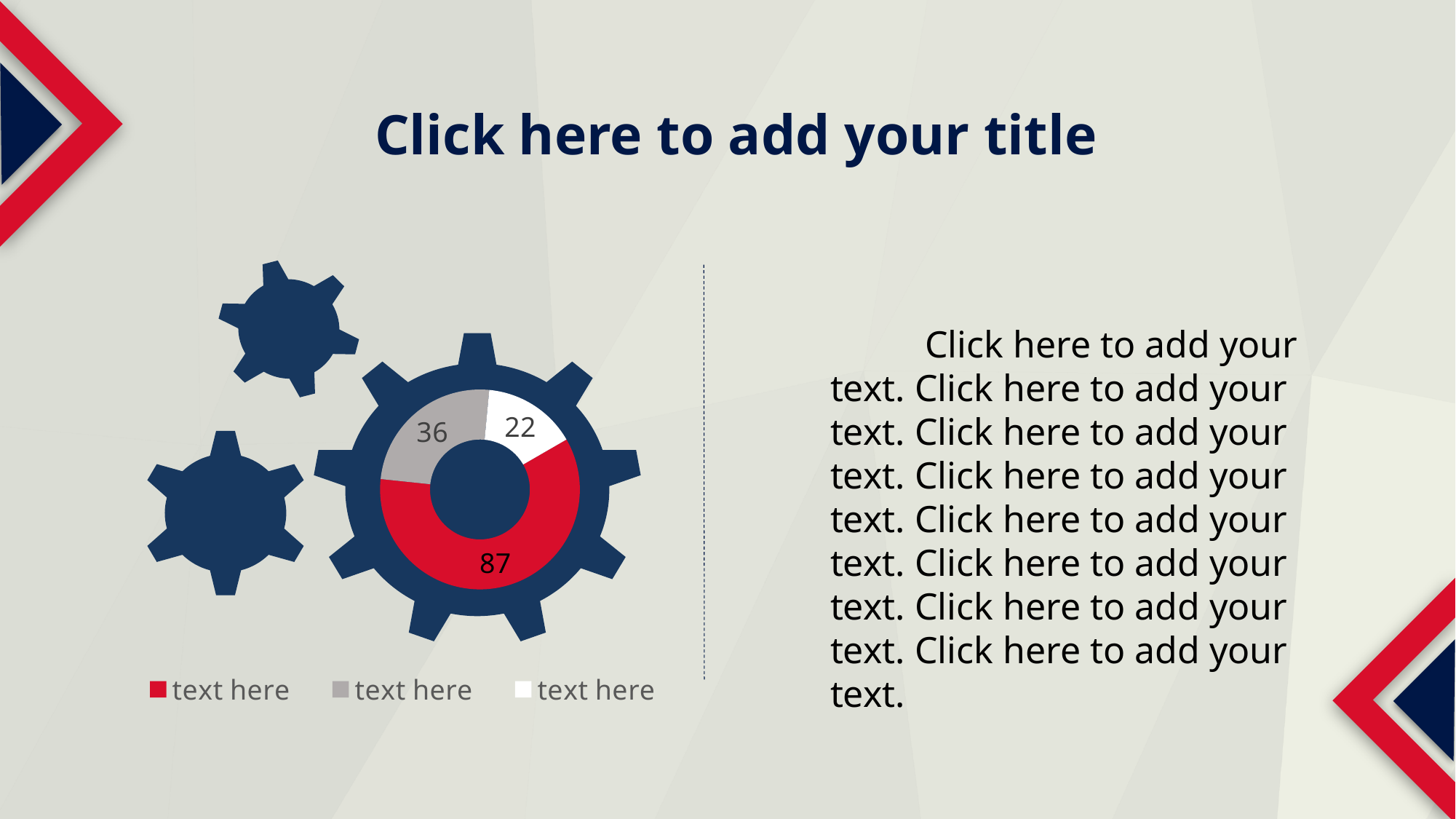
What is the value of the red slice in the doughnut chart? 87 Which slice of the doughnut chart has the largest value? The red slice (87) What is the total of all three slice values in the doughnut chart? 145 Which is larger, the grey slice or the white slice? The grey slice What is the value of the grey slice in the doughnut chart? 36 What is the value of the white slice in the doughnut chart? 22 What is the difference between the grey slice and the white slice values? 14 Which slice of the doughnut chart has the smallest value? The white slice (22) What type of chart is shown on the slide? Doughnut chart What is the difference between the red slice and the grey slice values? 51 How many slices does the doughnut chart have? 3 How many entries does the chart legend list? 3